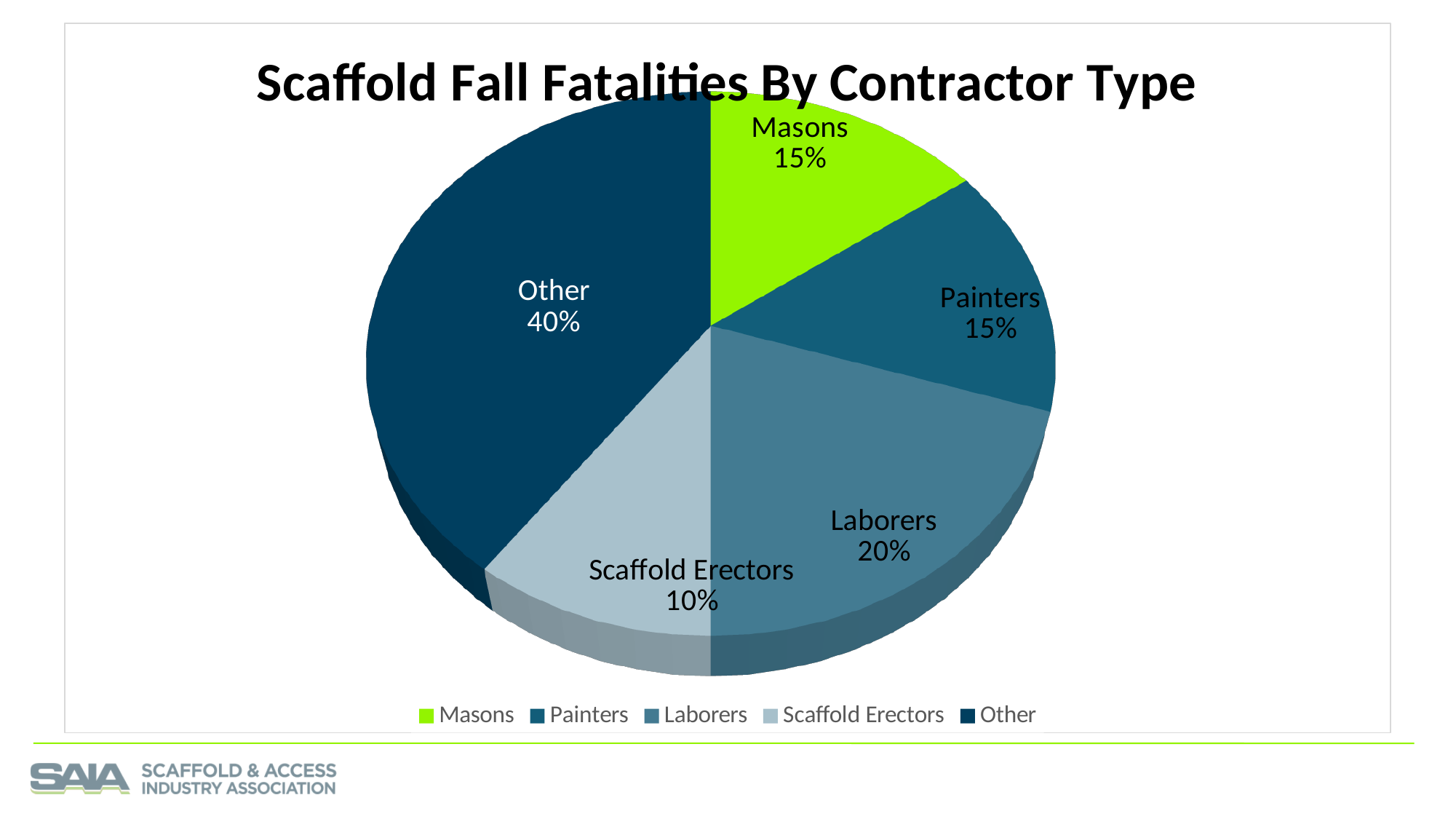
What kind of chart is shown on the slide? Pie chart How many contractor types are shown in the pie chart? 5 How many entries does the legend list? 5 What percentage of the pie is labelled Laborers? 20% What share of scaffold fall fatalities is attributed to Masons? 15% Which has a larger share, Laborers or Painters? Laborers What percentage is shown for the Other category? 40% What share is shown for Scaffold Erectors? 10% What is the difference in percentage points between the Other slice and the Laborers slice? 20 What is the title of the chart? Scaffold Fall Fatalities By Contractor Type Which contractor type has the smallest share of scaffold fall fatalities? Scaffold Erectors Which contractor type has the largest share of scaffold fall fatalities? Other